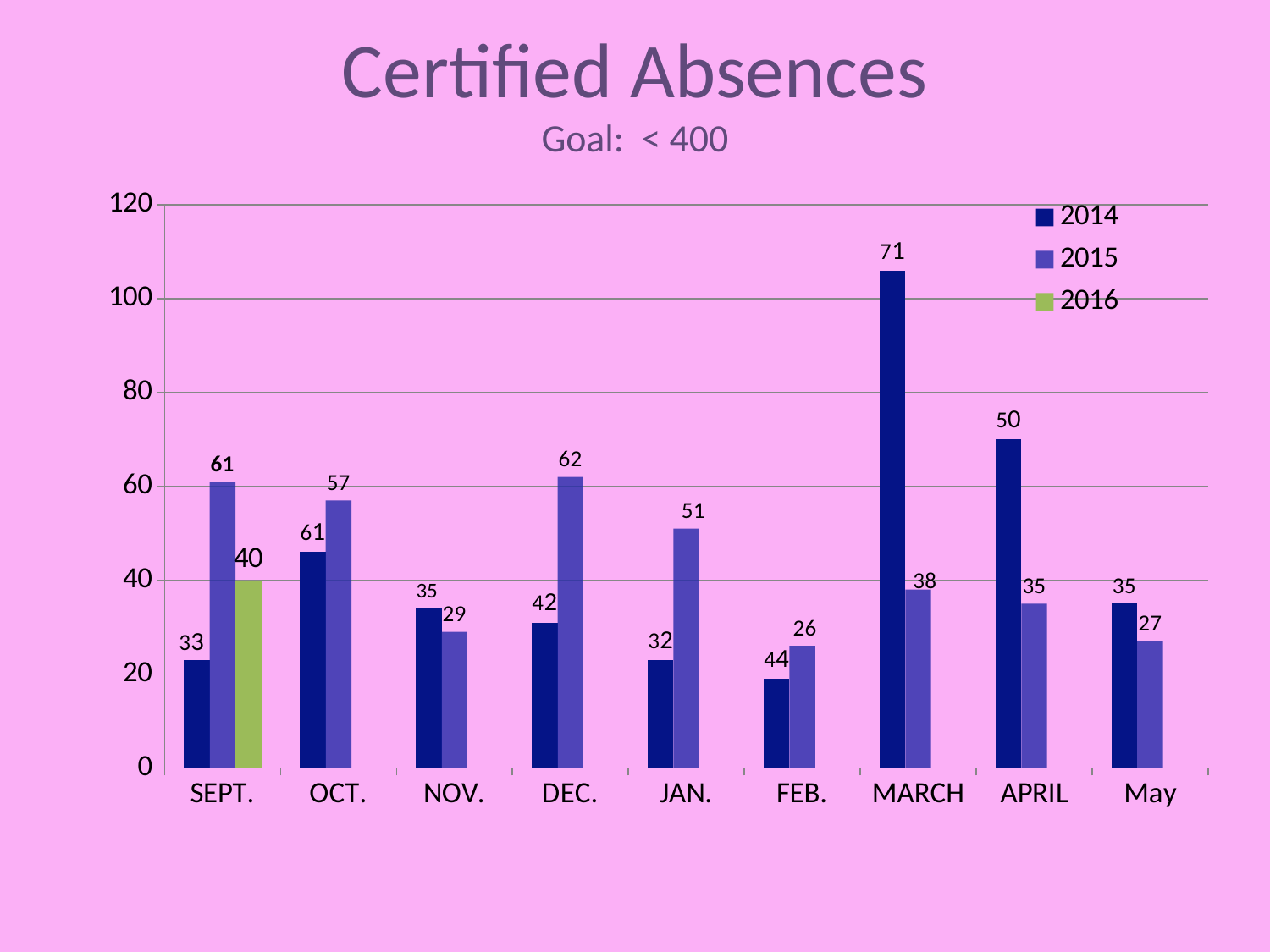
Which series is shown in green? 2016 How many series does the legend list? 3 What is the value for 2015 in MARCH? 38 What is the goal stated under the chart title? < 400 What is the difference between the 2015 values for DEC. and FEB.? 36 What type of chart is shown on the slide? bar chart What is the value for 2015 in NOV.? 29 Which month has the lowest value for 2015? FEB. Which month has the highest value for 2015? DEC. Which is larger for 2015: OCT. or JAN.? OCT. What is the value for 2016 in SEPT.? 40 How many months are shown on the x axis? 9